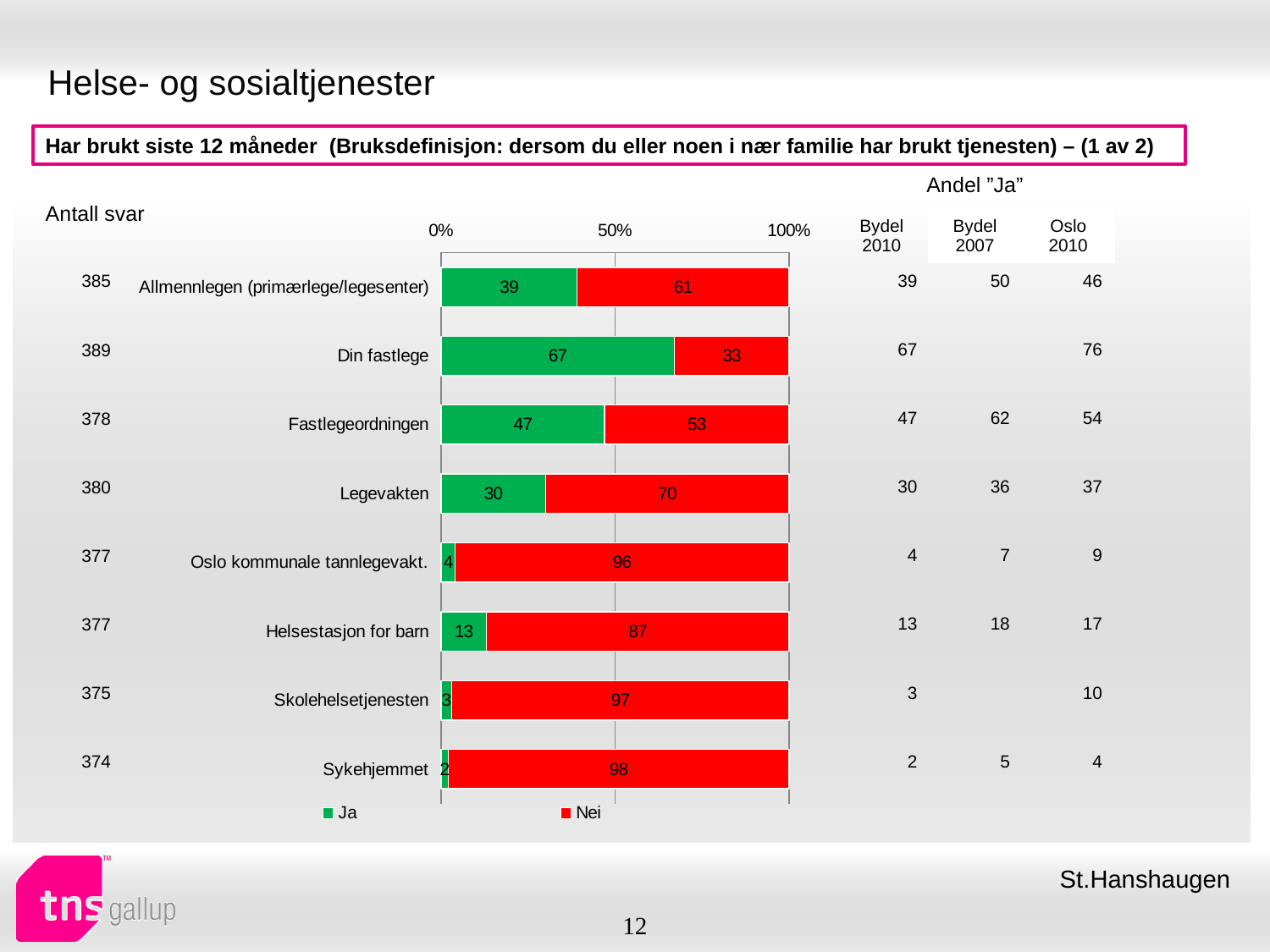
Which is larger for Fastlegeordningen, the "Ja" value or the "Nei" value? Nei What are the two series named in the legend? Ja and Nei How many series does the legend list? 2 What kind of chart is shown on the slide? Stacked bar chart How many categories are shown in the chart? 8 What is the difference between the "Nei" and "Ja" values for Legevakten? 40 What is the "Ja" value for Helsestasjon for barn? 13 Is the "Nei" value for Allmennlegen (primærlege/legesenter) greater or less than 50%? greater Which category has the lowest "Ja" value? Sykehjemmet What is the "Ja" value for Din fastlege? 67 What is the "Nei" value for Legevakten? 70 Which category has the highest "Ja" value? Din fastlege